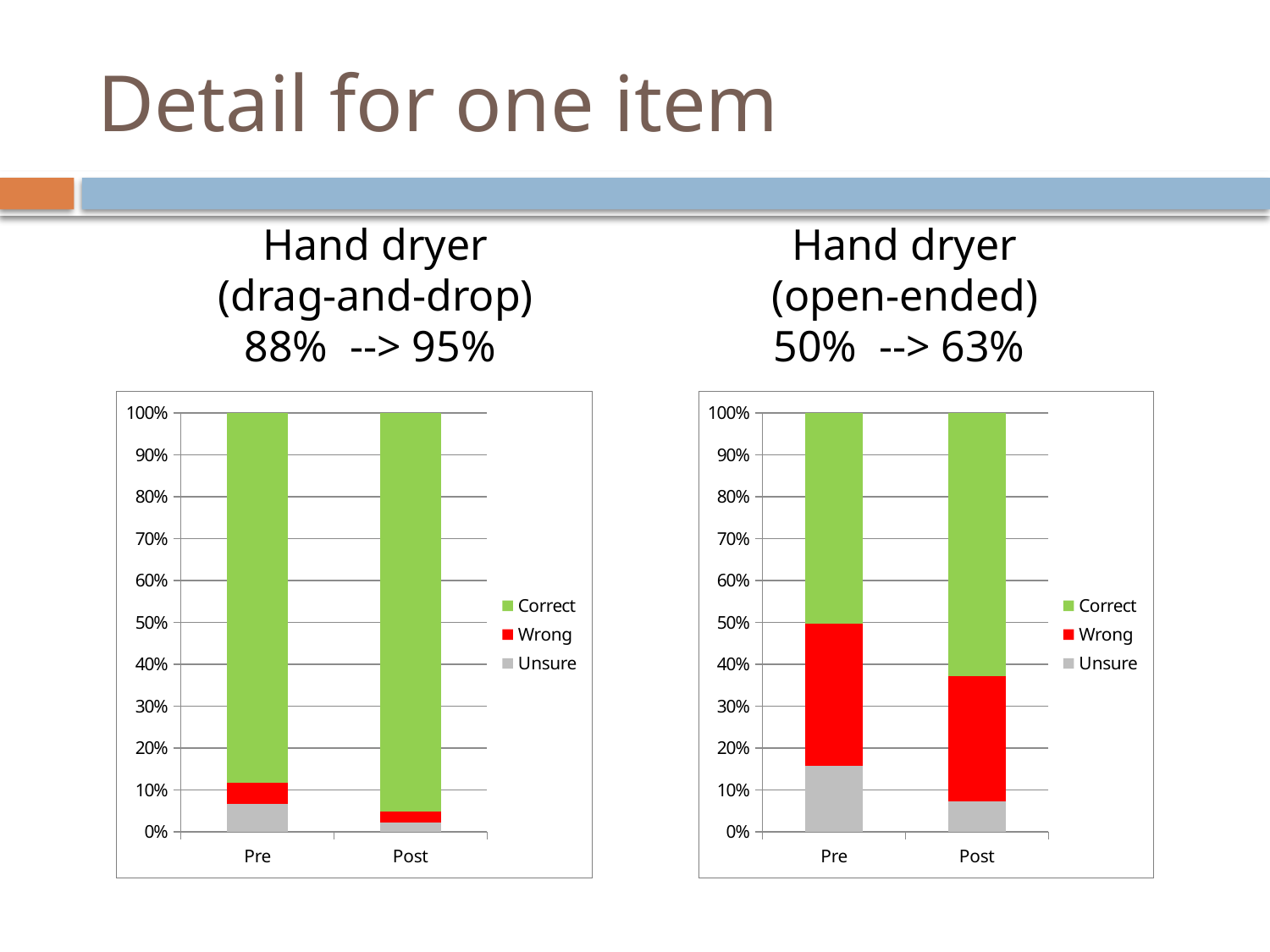
According to the title of the Hand dryer (drag-and-drop) chart, what was the Correct percentage at Pre? 88% Which colour represents the Wrong series in the Hand dryer (drag-and-drop) chart? red In the Hand dryer (open-ended) chart, is the Unsure share at Pre greater or less than 10%? greater According to the title of the Hand dryer (open-ended) chart, what was the Correct percentage at Post? 63% What type of chart is the Hand dryer (drag-and-drop) chart? stacked bar chart In the Hand dryer (open-ended) chart, by how many percentage points did the Correct share change from Pre to Post, based on the values in the title? 13 According to the title of the Hand dryer (drag-and-drop) chart, what was the Correct percentage at Post? 95% In the Hand dryer (open-ended) chart, does the Correct share rise or fall from Pre to Post? rise How many series does the legend of the Hand dryer (open-ended) chart list? 3 In the Hand dryer (drag-and-drop) chart, is the Unsure share at Pre greater or less than 10%? less How many categories are shown on the x axis of the Hand dryer (drag-and-drop) chart? 2 According to the title of the Hand dryer (open-ended) chart, what was the Correct percentage at Pre? 50%